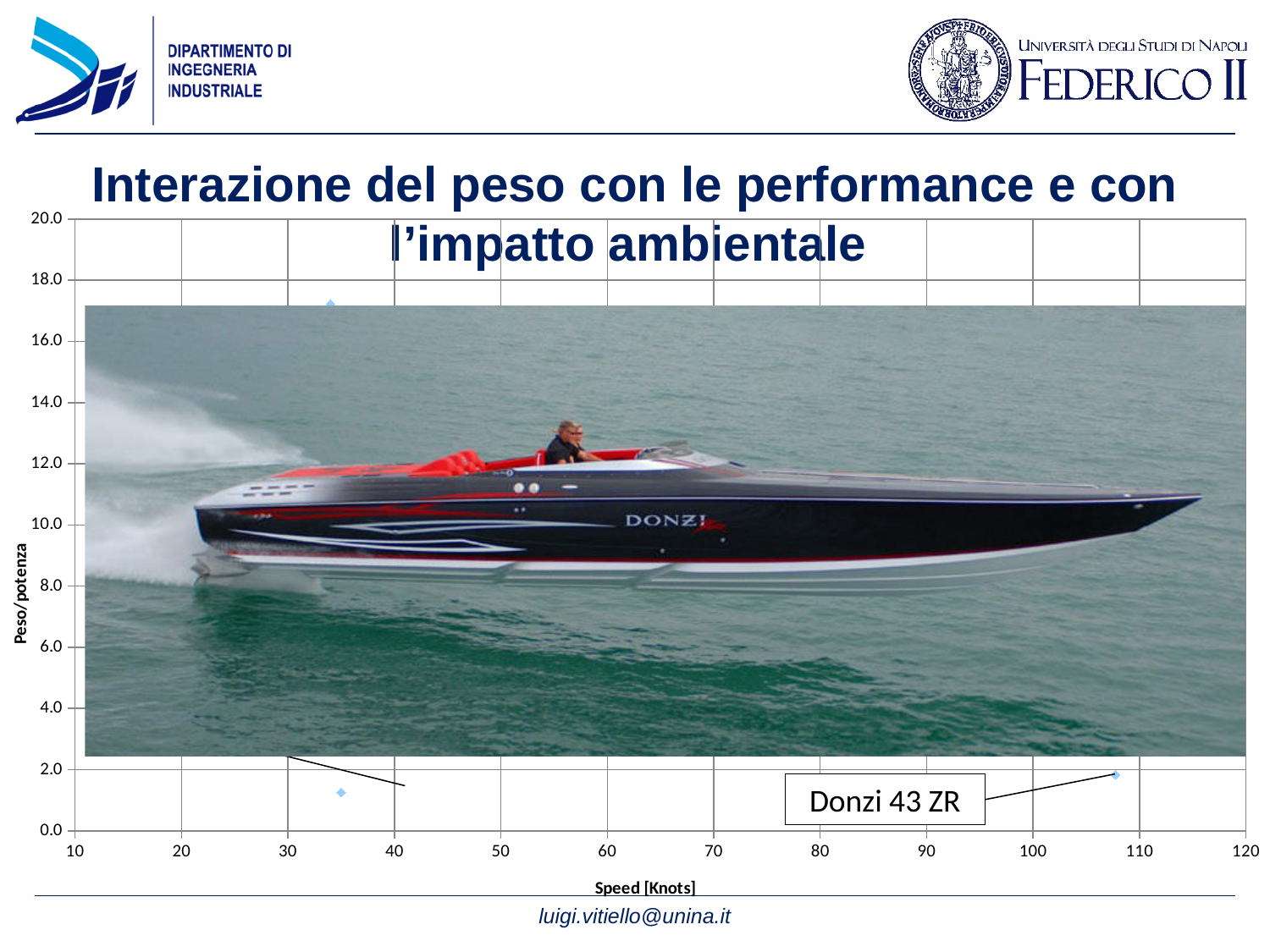
Is the Peso/potenza value of the Donzi 43 ZR point greater or less than 4.0? less Is the speed of the Donzi 43 ZR point greater or less than 100 knots? greater Is the Peso/potenza value of the data point plotted near 34 knots at the top of the chart greater or less than 16.0? greater What kind of chart is shown on the slide? scatter chart What is the title of the horizontal axis of the chart? Speed [Knots] Which boat is named in the callout label pointing to the data point near 108 knots? Donzi 43 ZR Which has the higher speed: the Donzi 43 ZR point or the data point plotted near 35 knots at the bottom of the chart? Donzi 43 ZR Which has the higher Peso/potenza value: the Donzi 43 ZR point or the data point plotted near 34 knots at the top of the chart? the point near 34 knots at the top